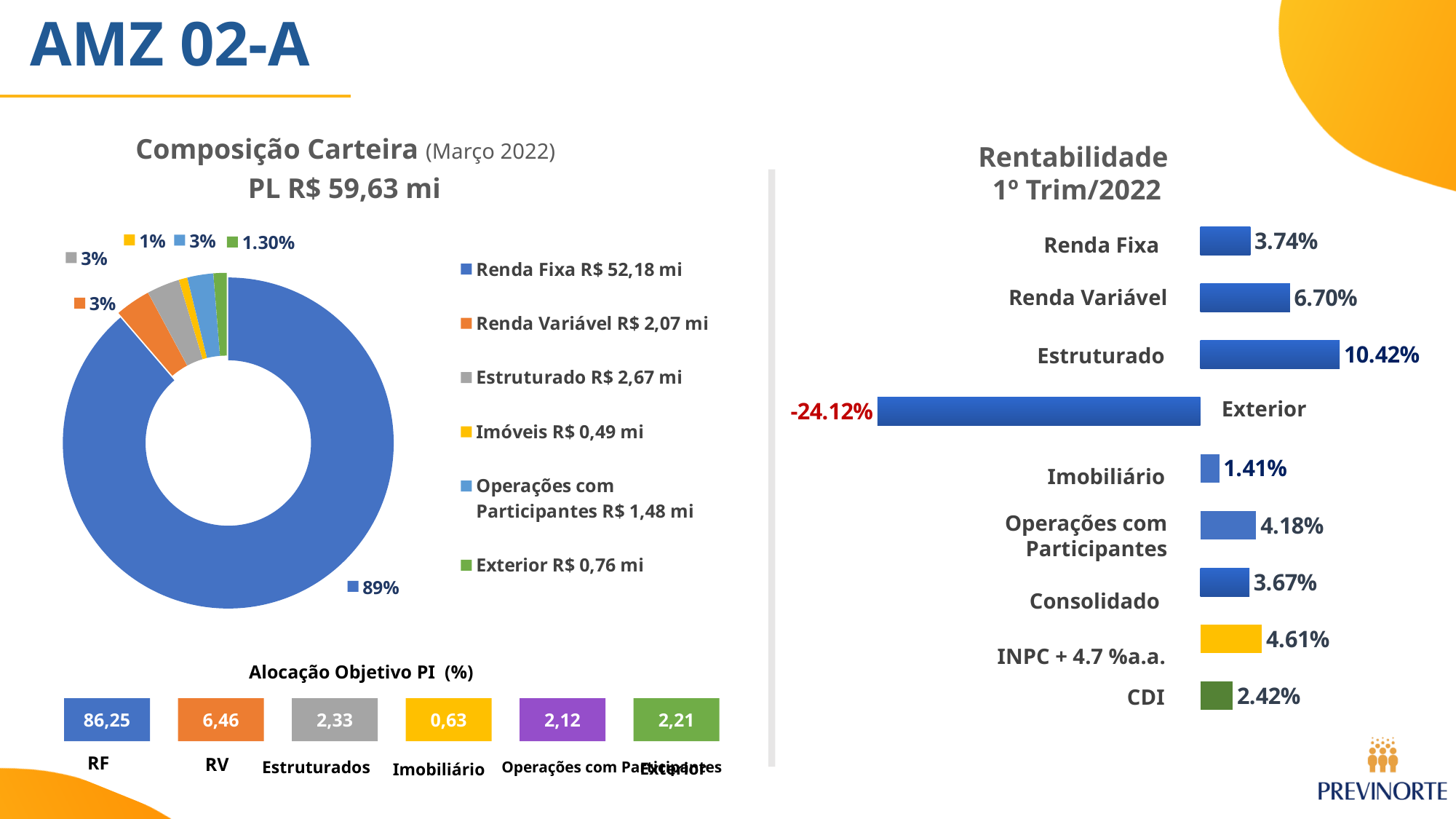
In the Composição Carteira chart, what share of the portfolio is Renda Fixa? 89% In the Composição Carteira chart, what is the value shown in the legend for Estruturado? R$ 2,67 mi In the Rentabilidade 1º Trim/2022 chart, which is larger: Consolidado or INPC + 4.7 %a.a.? INPC + 4.7 %a.a. In the Rentabilidade 1º Trim/2022 chart, which category has the highest value? Estruturado In the Rentabilidade 1º Trim/2022 chart, what is the difference between Renda Variável and Renda Fixa? 2.96% In the Rentabilidade 1º Trim/2022 chart, what is the value for Estruturado? 10.42% How many categories are shown in the Rentabilidade 1º Trim/2022 chart? 9 In the Rentabilidade 1º Trim/2022 chart, what is the value for Exterior? -24.12% In the Rentabilidade 1º Trim/2022 chart, which category has the lowest value? Exterior What kind of chart is the Composição Carteira chart? Donut chart In the Rentabilidade 1º Trim/2022 chart, what is the value for CDI? 2.42% What kind of chart is the Rentabilidade 1º Trim/2022 chart? Bar chart